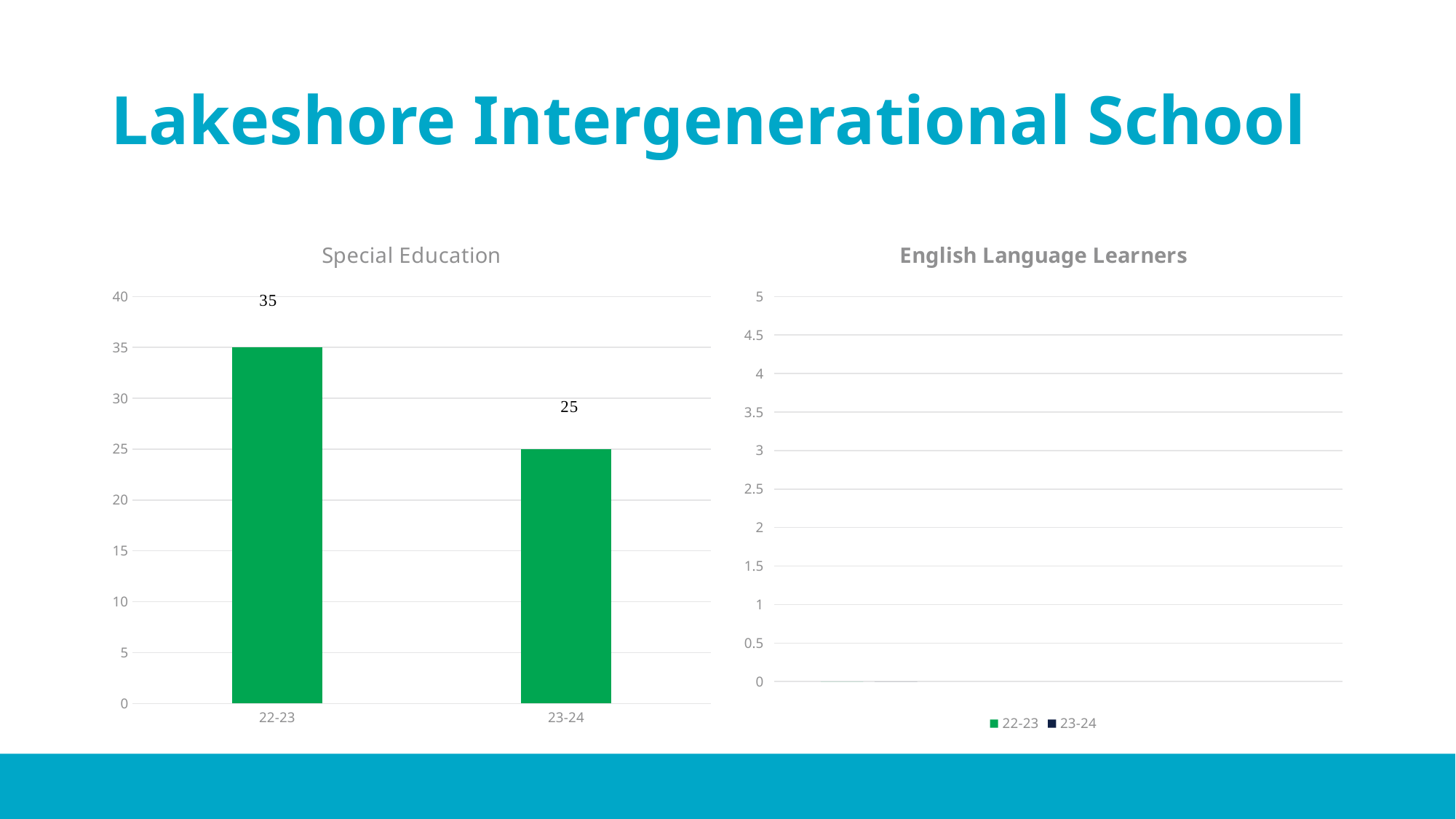
What is the title of the chart on the right side of the slide? English Language Learners In the Special Education chart, is the value for 22-23 larger or smaller than the value for 23-24? larger In the Special Education chart, do the values rise or fall from 22-23 to 23-24? fall In the Special Education chart, which year has the higher value? 22-23 In the Special Education chart, what is the value for 23-24? 25 In the Special Education chart, which year has the lower value? 23-24 How many series does the legend of the English Language Learners chart list? 2 In the Special Education chart, what is the difference between the 22-23 and 23-24 values? 10 In the Special Education chart, is the value for 23-24 greater or less than 30? less How many bars are shown in the Special Education chart? 2 What kind of chart is the Special Education chart? bar chart In the Special Education chart, what is the value for 22-23? 35